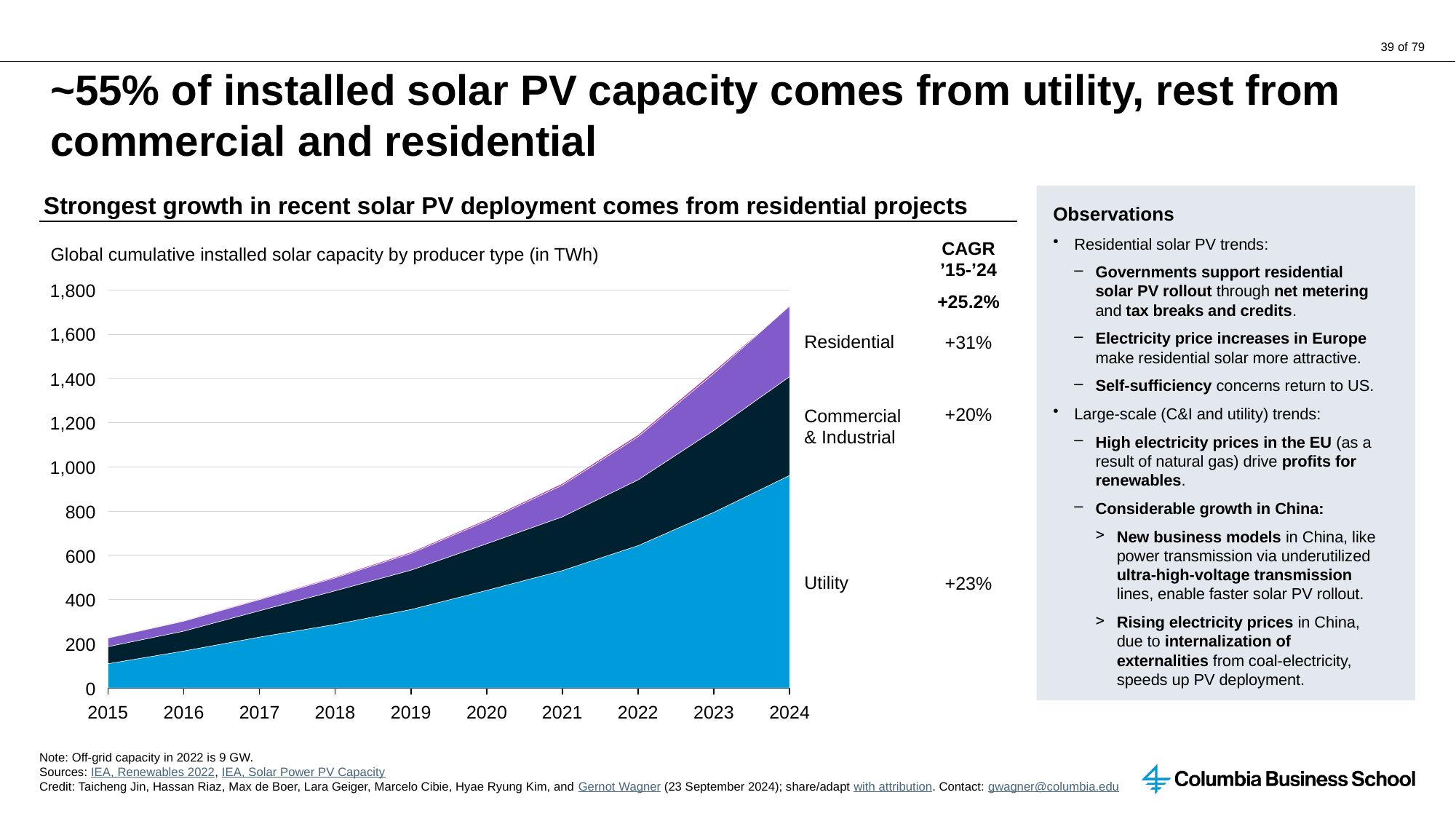
Is the Utility capacity in 2024 greater or less than 1,000? less Does the total cumulative installed solar capacity rise or fall from 2015 to 2024? Rises What is the overall CAGR '15-'24 shown at the top of the CAGR column? +25.2% Which producer type has the highest CAGR '15-'24? Residential What is the CAGR '15-'24 shown for Utility? +23% What is the CAGR '15-'24 shown for Commercial & Industrial? +20% Which producer type has the lowest CAGR '15-'24? Commercial & Industrial What is the CAGR '15-'24 shown for Residential? +31% What kind of chart is shown on the slide? Stacked area chart Is the total cumulative installed solar capacity in 2024 greater or less than 1,600? greater How many years are shown on the x axis of the chart? 10 Which has the larger CAGR '15-'24, Utility or Commercial & Industrial? Utility